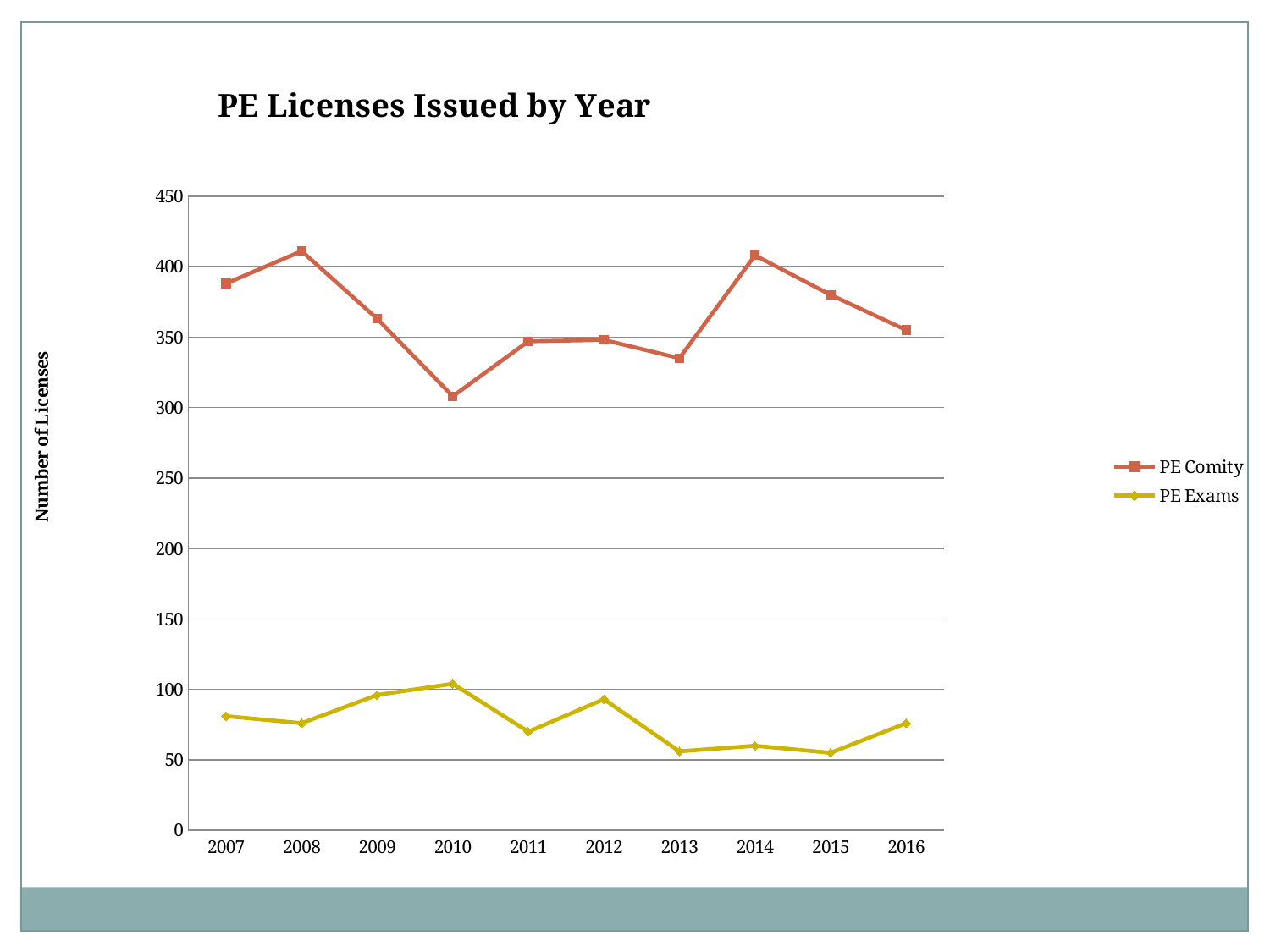
Is the PE Comity value for 2008 greater or less than 400? greater Does the PE Comity line rise or fall from 2008 to 2010? Fall What is the title of the y axis? Number of Licenses In which year is the PE Comity value lowest? 2010 How many years are plotted along the x axis? 10 In which year is the PE Exams value highest? 2010 How many series does the legend list? 2 Is the PE Comity value for 2010 greater or less than 350? less Is the PE Exams value for 2011 greater or less than 100? less Which is larger, the PE Comity value for 2007 or for 2010? 2007 What kind of chart is shown on the slide? Line chart Which is larger, the PE Exams value for 2012 or for 2013? 2012